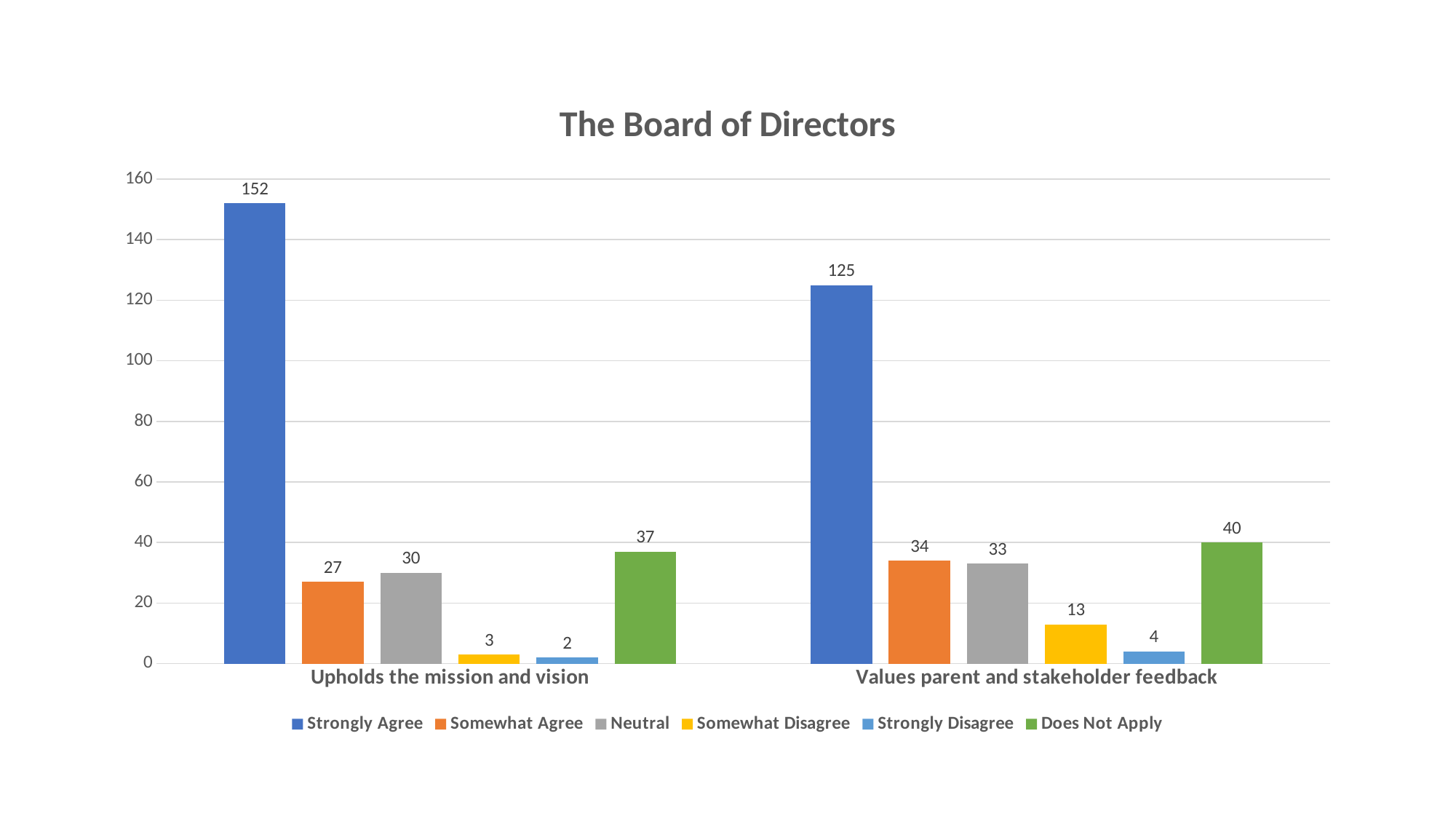
What is the value for Does Not Apply in the 'Upholds the mission and vision' category? 37 Which is larger: Neutral for 'Upholds the mission and vision' or Neutral for 'Values parent and stakeholder feedback'? Values parent and stakeholder feedback What is the title of the chart? The Board of Directors What is the difference between the Strongly Agree values for 'Upholds the mission and vision' and 'Values parent and stakeholder feedback'? 27 Which series has the lowest value in the 'Upholds the mission and vision' category? Strongly Disagree What kind of chart is shown on the slide? bar chart How many categories are shown on the x axis? 2 Which series has the highest value in the 'Values parent and stakeholder feedback' category? Strongly Agree What is the value for Strongly Agree in the 'Upholds the mission and vision' category? 152 Is the Strongly Agree value for 'Values parent and stakeholder feedback' greater or less than 140? less What is the value for Somewhat Disagree in the 'Values parent and stakeholder feedback' category? 13 How many series does the legend list? 6